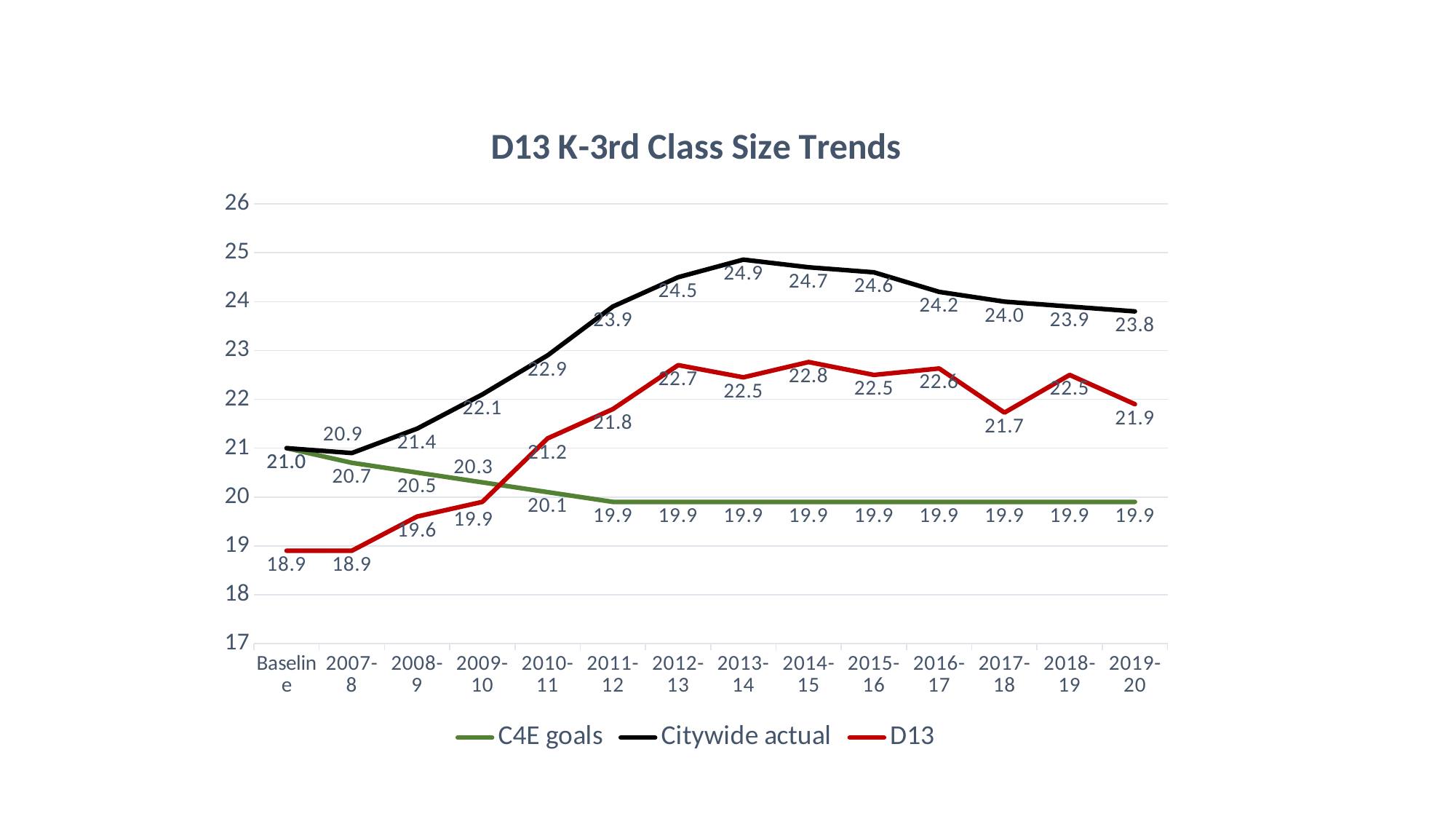
What is the C4E goals value for 2009-10? 20.3 What is the difference between the Citywide actual and D13 values in 2019-20? 1.9 In which year does the Citywide actual series reach its highest value? 2013-14 Which is larger for D13: the value in 2012-13 or the value in 2013-14? 2012-13 Do the C4E goals values rise or fall from Baseline to 2011-12? fall Is the Citywide actual value for 2012-13 greater or less than 24? greater How many series does the legend list? 3 What is the D13 value for 2017-18? 21.7 What kind of chart is shown on the slide? line chart How many points are plotted along the x axis for each series? 14 What colour is the D13 line in the legend? red What is the Citywide actual value for 2013-14? 24.9